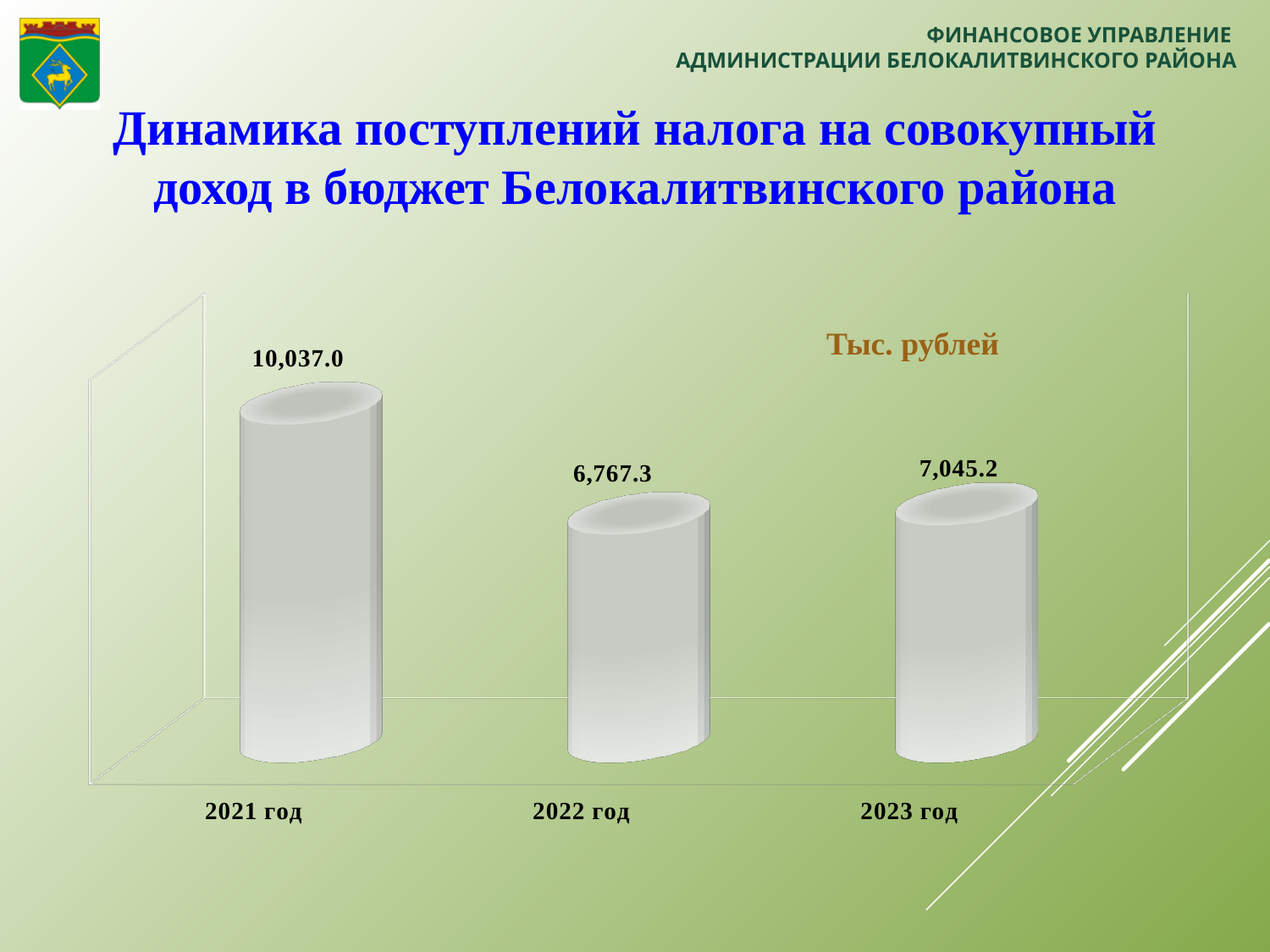
What is the value for 2023 год? 7,045.2 In what units are the values on the chart given? Тыс. рублей What kind of chart is shown on the slide? Bar chart How many years are shown on the chart? 3 Which is larger, the value for 2022 год or the value for 2023 год? 2023 год What is the difference between the values for 2023 год and 2022 год? 277.9 Did the value rise or fall from 2021 год to 2022 год? Fall What is the value for 2021 год? 10,037.0 Which year has the lowest value? 2022 год What is the difference between the values for 2021 год and 2022 год? 3,269.7 What is the value for 2022 год? 6,767.3 Which year has the highest value? 2021 год